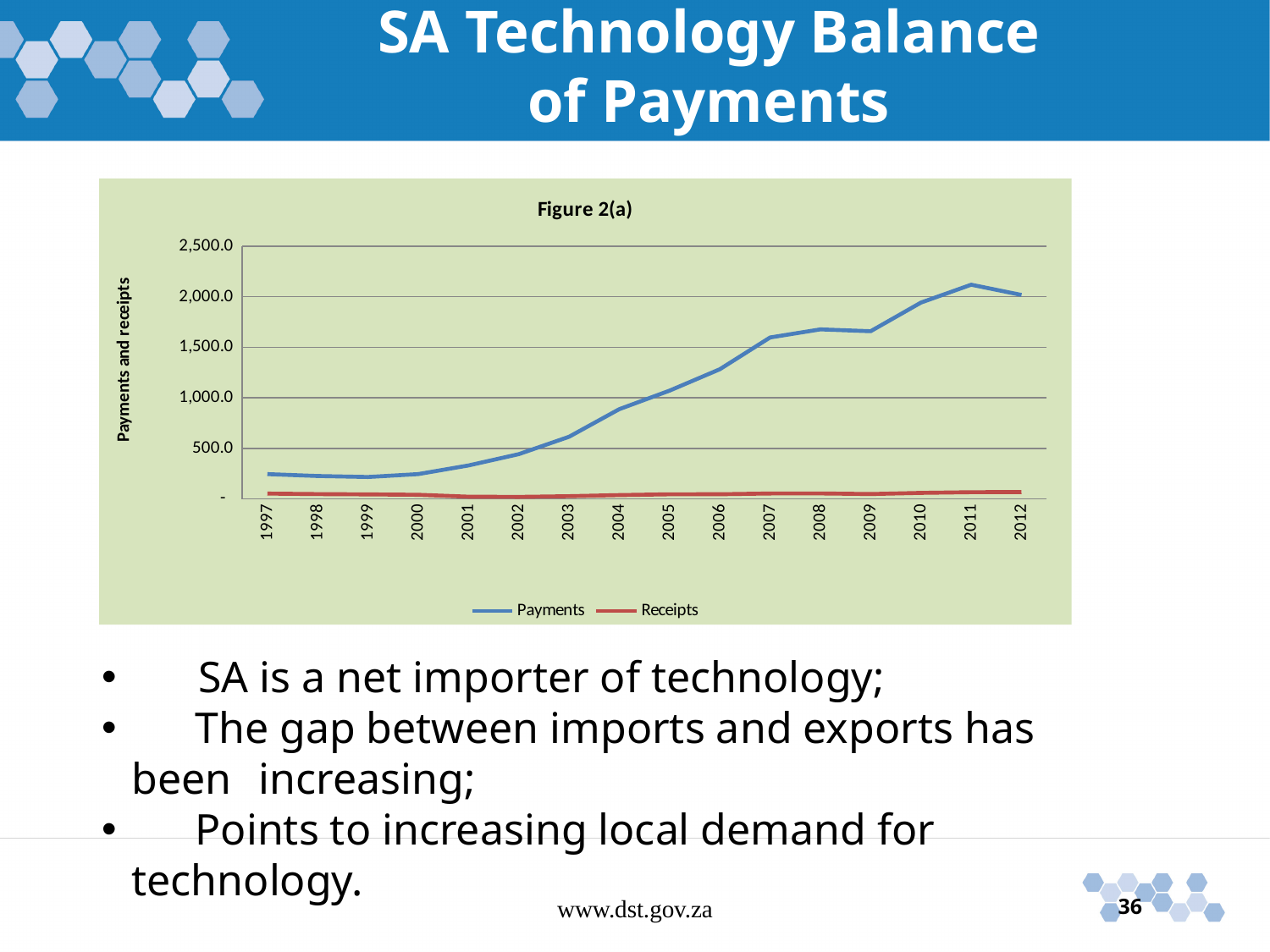
Is the Payments value for 2011 in Figure 2(a) greater or less than 2,000.0? greater How many years are shown on the x axis of Figure 2(a)? 16 Do the Payments values in Figure 2(a) generally rise or fall from 1997 to 2012? rise In 2012, which series in Figure 2(a) has the larger value, Payments or Receipts? Payments In which year does the Payments series in Figure 2(a) reach its highest value? 2011 Is the Payments value for 2010 in Figure 2(a) greater or less than 1,500.0? greater What is the label on the vertical axis of Figure 2(a)? Payments and receipts Which colour is used for the Receipts series in Figure 2(a)? red How many series does the legend of Figure 2(a) list? 2 What kind of chart is Figure 2(a)? line chart Is the Receipts value for 2012 in Figure 2(a) greater or less than 500.0? less